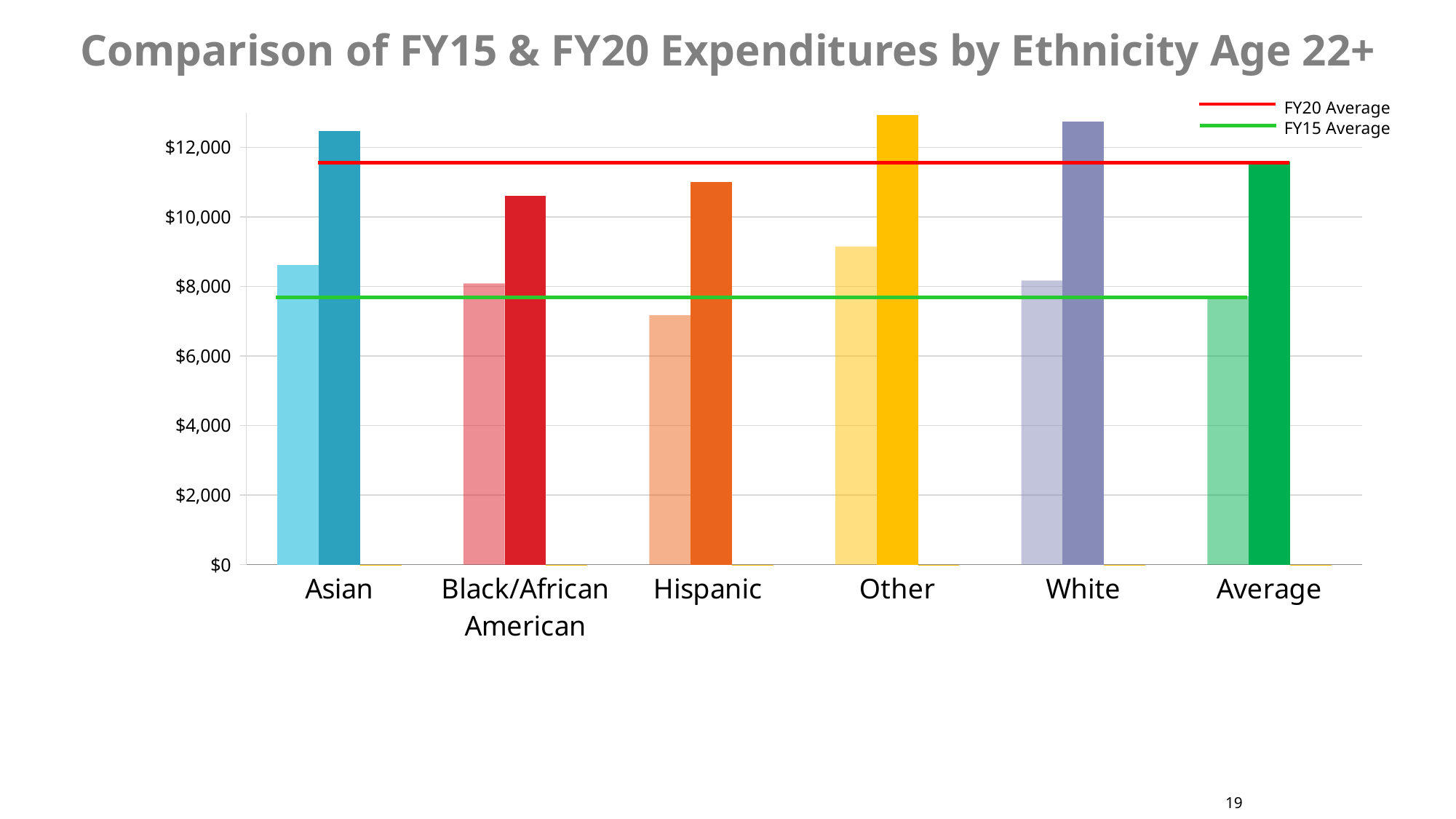
Is the value of the darker (taller) bar for Black/African American greater or less than $10,000? greater Which legend entry is drawn as a red line? FY20 Average How many categories are shown along the x axis? 6 Is the value of the darker (taller) bar for Other greater or less than $12,000? greater Which is larger: the darker (taller) bar for Asian or the darker (taller) bar for Black/African American? Asian Among the lighter (shorter) bars, which category has the lowest value? Hispanic What kind of chart is shown on the slide? bar chart Is the FY15 Average line greater or less than $8,000? less What is the title of the chart? Comparison of FY15 & FY20 Expenditures by Ethnicity Age 22+ How many entries does the legend list? 2